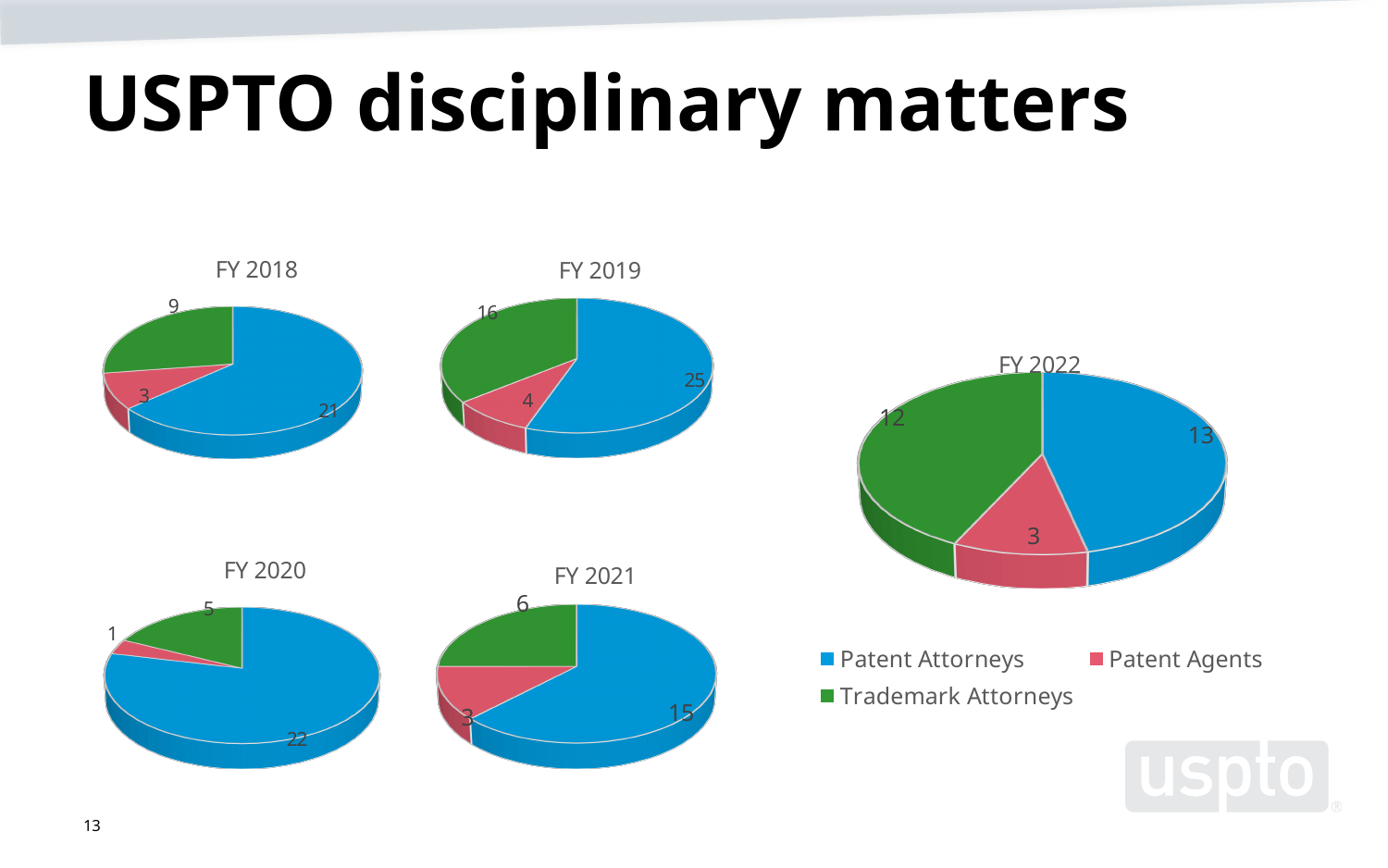
In the FY 2022 chart, which is larger, Patent Attorneys or Patent Agents? Patent Attorneys In the FY 2019 chart, which category has the smallest slice? Patent Agents In the FY 2022 chart, what is the value for Trademark Attorneys? 12 What kind of chart is used for FY 2022? Pie chart In the FY 2021 chart, which category has the largest slice? Patent Attorneys In the FY 2021 chart, what share of the total does Trademark Attorneys represent? 25% In the FY 2018 chart, what is the difference between Patent Attorneys and Trademark Attorneys? 12 In the FY 2018 chart, what is the value for Patent Attorneys? 21 In the FY 2020 chart, what is the value for Patent Agents? 1 In the FY 2019 chart, what is the value for Trademark Attorneys? 16 How many series does the legend list? 3 In the FY 2020 chart, what is the total of all three slices? 28